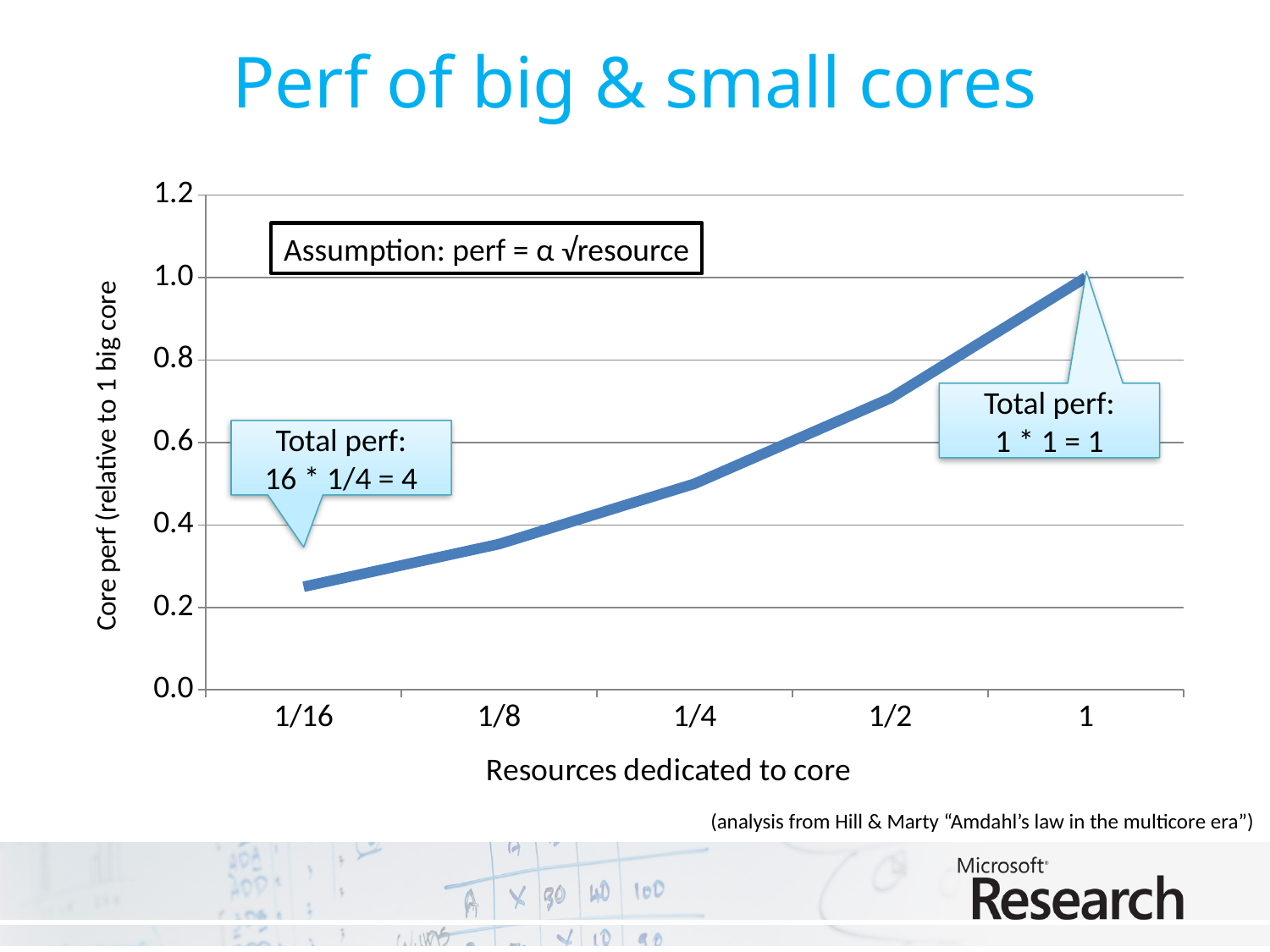
Which resources-dedicated-to-core category has the lowest core perf? 1/16 What is the title of the x axis? Resources dedicated to core How many data points are plotted on the line? 5 Which has a higher core perf: 1/2 resources or 1/8 resources? 1/2 Is the core perf value for 1/4 resources greater or less than 0.4? greater Is the core perf value for 1/2 resources greater or less than 0.6? greater What kind of chart is shown on the slide? line chart Is the core perf value for 1/16 resources greater or less than 0.4? less What is the core perf value when resources dedicated to core is 1? 1.0 What assumption is stated in the box inside the chart? perf = α √resource Do the core perf values rise or fall as resources dedicated to core increase along the x axis? rise Which resources-dedicated-to-core category has the highest core perf? 1